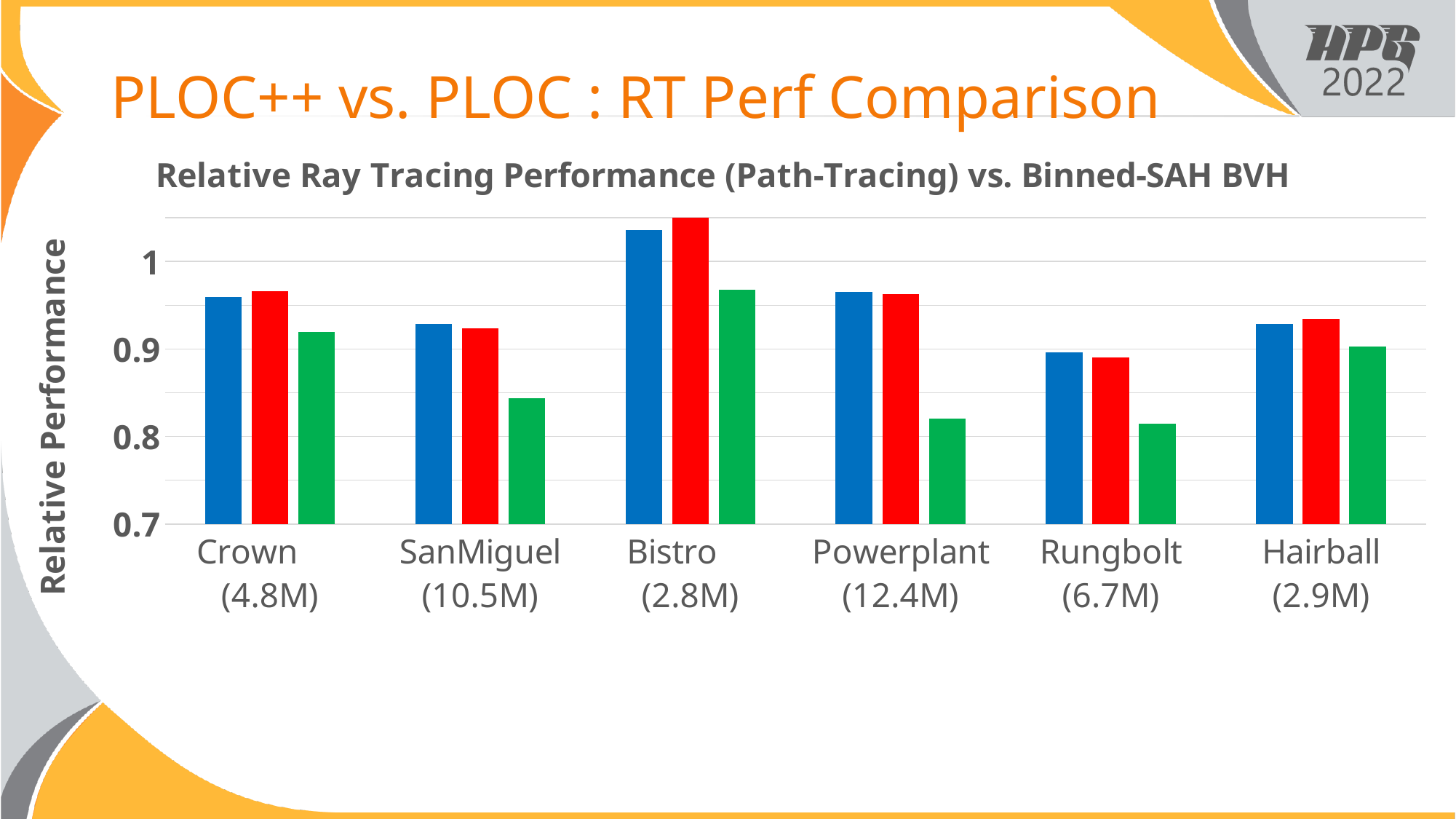
How many bars are plotted for each scene category? 3 How many scene categories are shown on the x axis of the chart? 6 For Crown (4.8M), which is larger, the blue bar or the green bar? the blue bar Which scene has the highest blue bar? Bistro (2.8M) What is the title of the chart? Relative Ray Tracing Performance (Path-Tracing) vs. Binned-SAH BVH Is the green bar for Crown (4.8M) greater or less than 0.9? greater Is the green bar for SanMiguel (10.5M) greater or less than 0.9? less Which scene has the lowest blue bar? Rungbolt (6.7M) What kind of chart is shown on the slide? bar chart Which scene has the highest green bar? Bistro (2.8M) What is the label on the vertical axis of the chart? Relative Performance Is the blue bar for Bistro (2.8M) greater or less than 1? greater